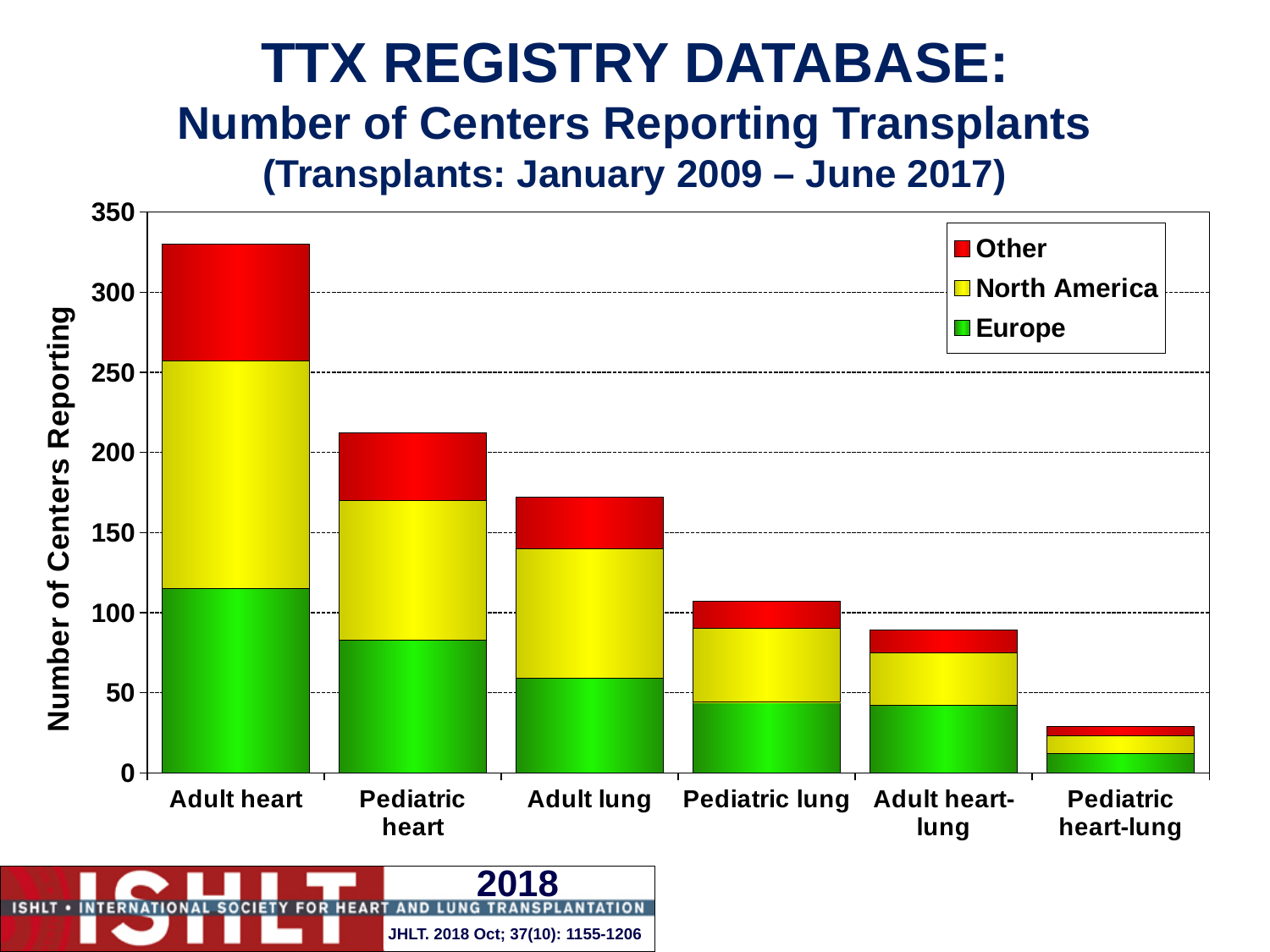
Which colour represents North America in the chart? Yellow How many transplant categories are shown on the x axis? 6 Is the Europe value for Adult heart greater or less than 100? greater What kind of chart is shown on the slide? Stacked bar chart Is the total number of centers reporting for Adult lung greater or less than 200? less Is the total number of centers reporting for Pediatric heart-lung greater or less than 50? less Which category has the lowest total number of centers reporting? Pediatric heart-lung Do the total bar heights rise or fall moving from left to right along the x axis? fall Which category has the highest total number of centers reporting? Adult heart Which has a larger total number of centers reporting, Pediatric heart or Adult lung? Pediatric heart How many series does the legend list? 3